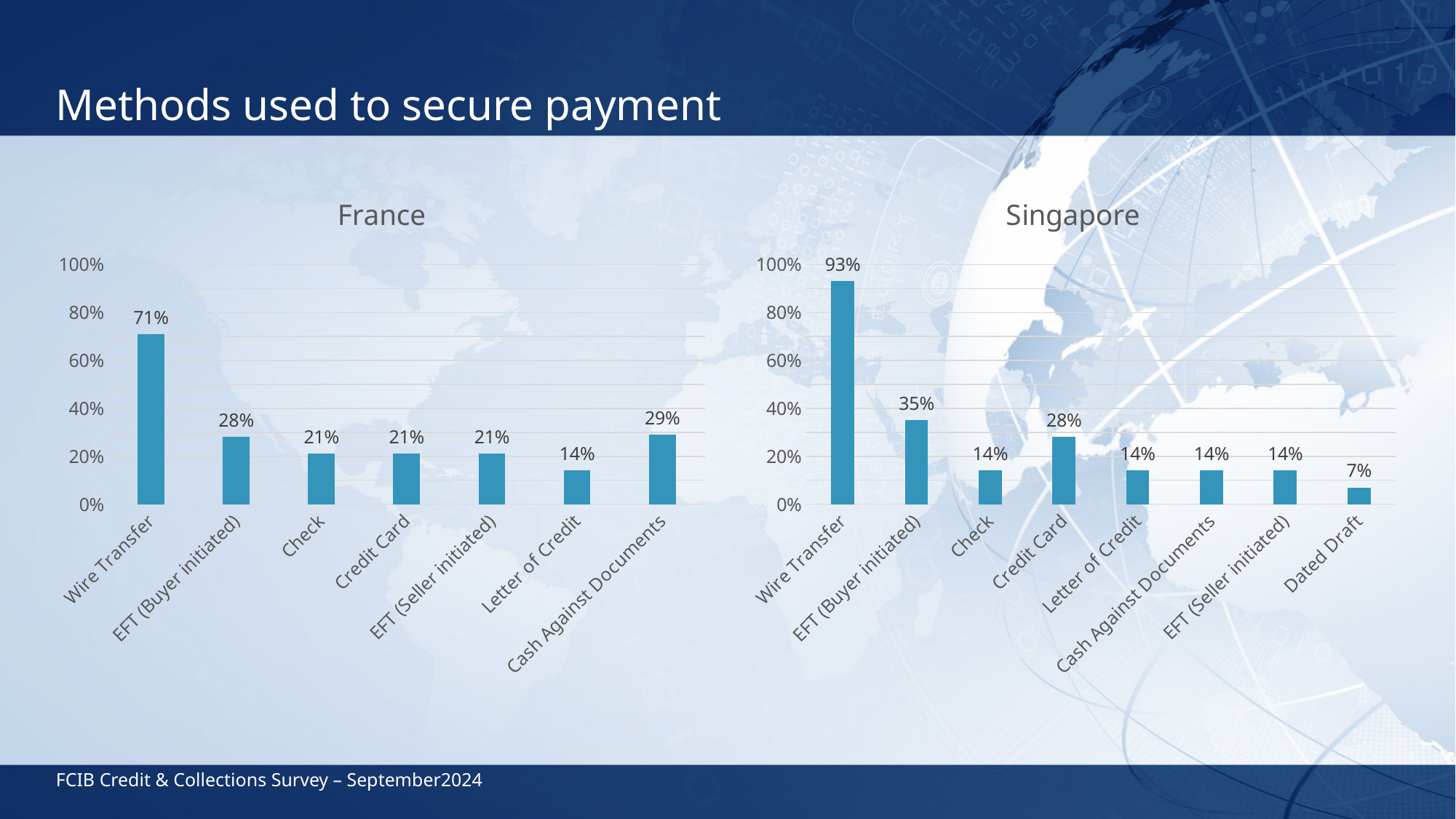
In the Singapore chart, which method has the lowest value? Dated Draft In the Singapore chart, is the value for Wire Transfer greater or less than 80%? greater In the Singapore chart, what is the value for EFT (Buyer initiated)? 35% In the Singapore chart, what is the value for Dated Draft? 7% In the France chart, which method has the lowest value? Letter of Credit In the France chart, which method has the highest value? Wire Transfer How many payment methods are shown in the Singapore chart? 8 What is the difference between the Wire Transfer values in the Singapore chart and the France chart? 22% In the France chart, which is larger: Cash Against Documents or EFT (Buyer initiated)? Cash Against Documents How many payment methods are shown in the France chart? 7 In the France chart, what is the value for Wire Transfer? 71% What type of chart is used for the France data? Bar chart